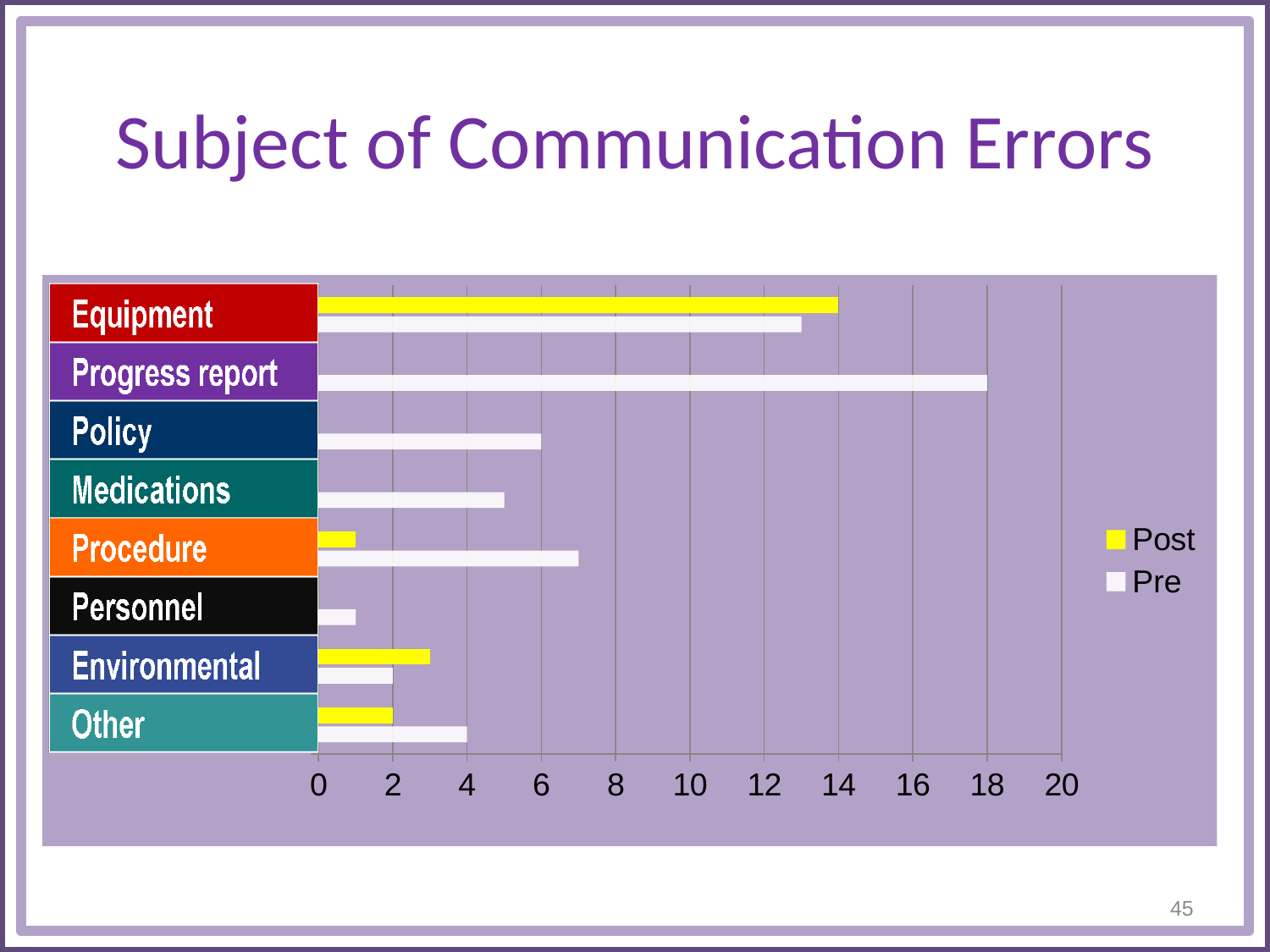
What kind of chart is shown on the slide? bar chart For Procedure, which is larger, the Pre value or the Post value? Pre What is the Pre value for Policy? 6 What is the difference between the Pre value for Progress report and the Pre value for Policy? 12 How many categories are shown on the chart? 8 What is the Pre value for Progress report? 18 Which category has the highest Pre value? Progress report Which category has the highest Post value? Equipment How many series does the legend list? 2 Is the Pre value for Procedure greater or less than 6? greater What is the Pre value for Other? 4 What is the Post value for Equipment? 14